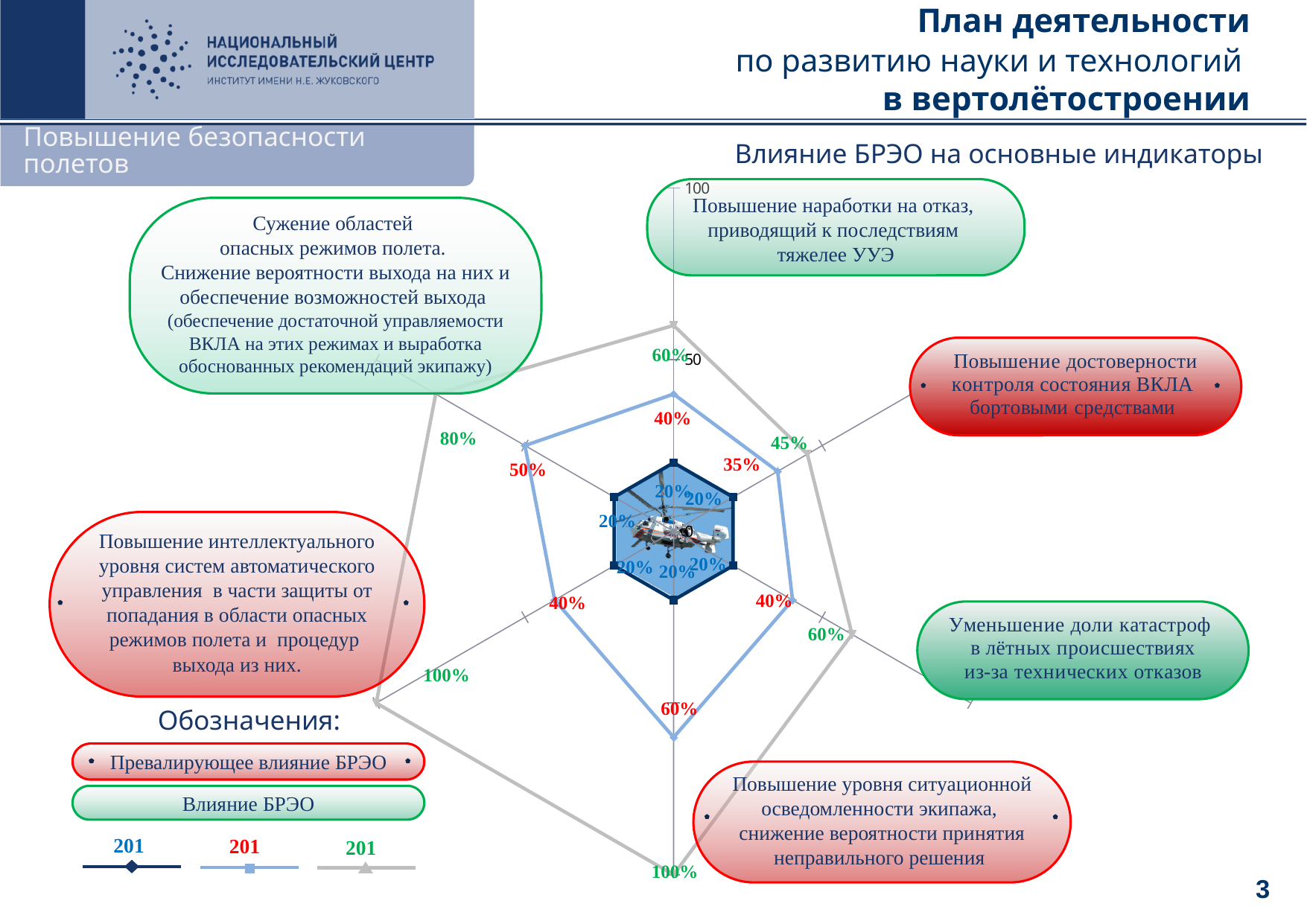
What is the title shown above the radar chart? Влияние БРЭО на основные индикаторы What is the lowest value labelled on the grey series of the radar chart? 45% What is the lowest value labelled on the light blue series of the radar chart? 35% What is the highest value labelled on the grey series of the radar chart? 100% What is the maximum tick value shown on the radar chart's axis scale? 100 What is the highest value labelled on the light blue series of the radar chart? 60% What value does the dark blue series show on every axis of the radar chart? 20% On the axis pointing straight down, what is the difference between the grey series value and the light blue series value? 40% How many axes (categories) does the radar chart have? 6 On the axis pointing straight up, which series has the larger value: the grey series or the light blue series? grey series What kind of chart is shown on the slide? radar chart How many series does the chart legend list? 3